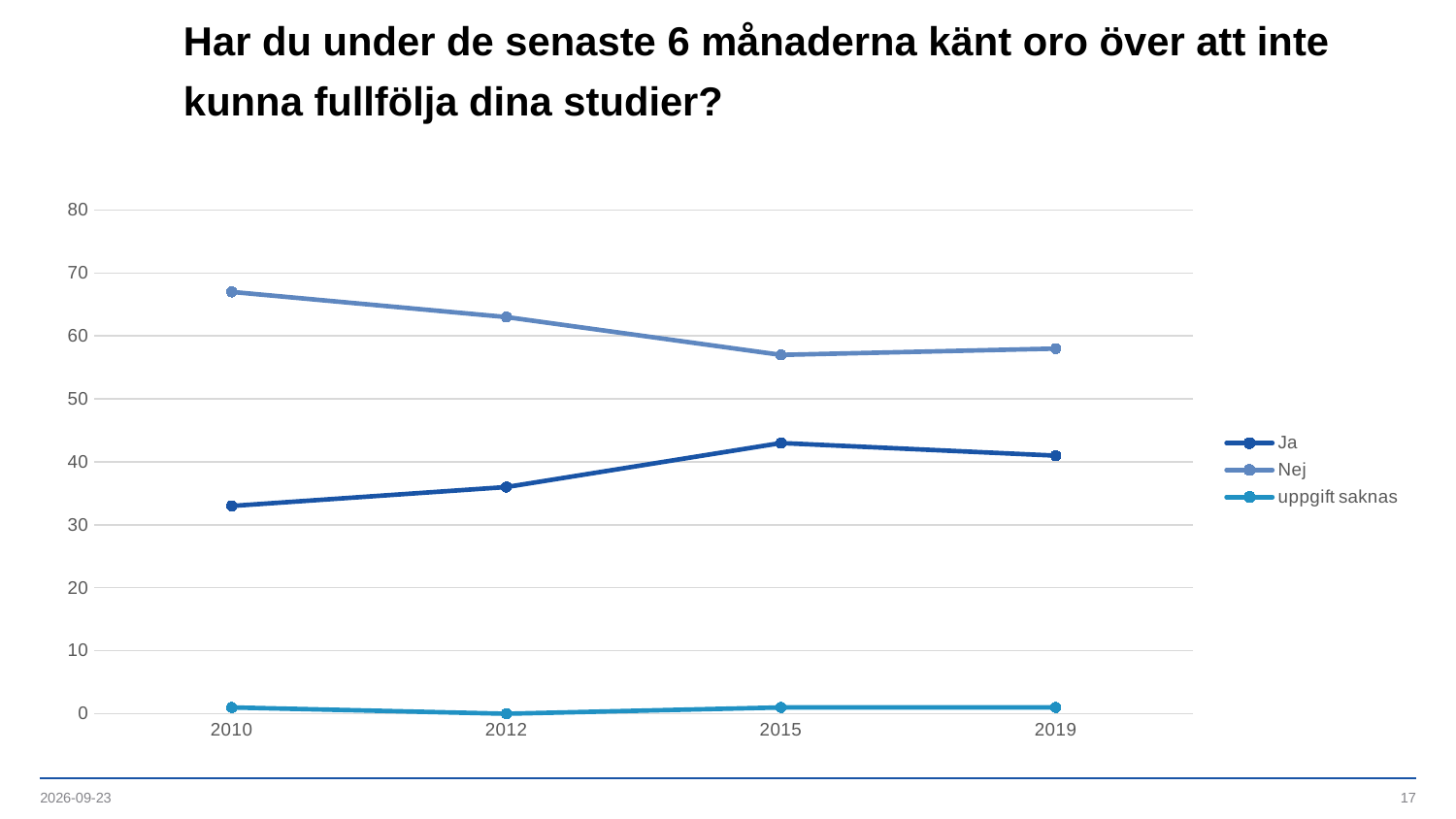
Does the Nej series rise or fall from 2010 to 2015? fall In which year is the Nej series at its highest? 2010 Is the value for Ja in 2015 greater or less than 40? greater What kind of chart is shown on the slide? line chart How many years are plotted along the x axis? 4 How many series does the legend list? 3 Is the value for Nej in 2010 greater or less than 60? greater Which series has the larger value in 2019, Ja or Nej? Nej In which year is the Ja series at its lowest? 2010 Which series stays close to 0 across all years? uppgift saknas Is the value for Nej in 2015 greater or less than 60? less